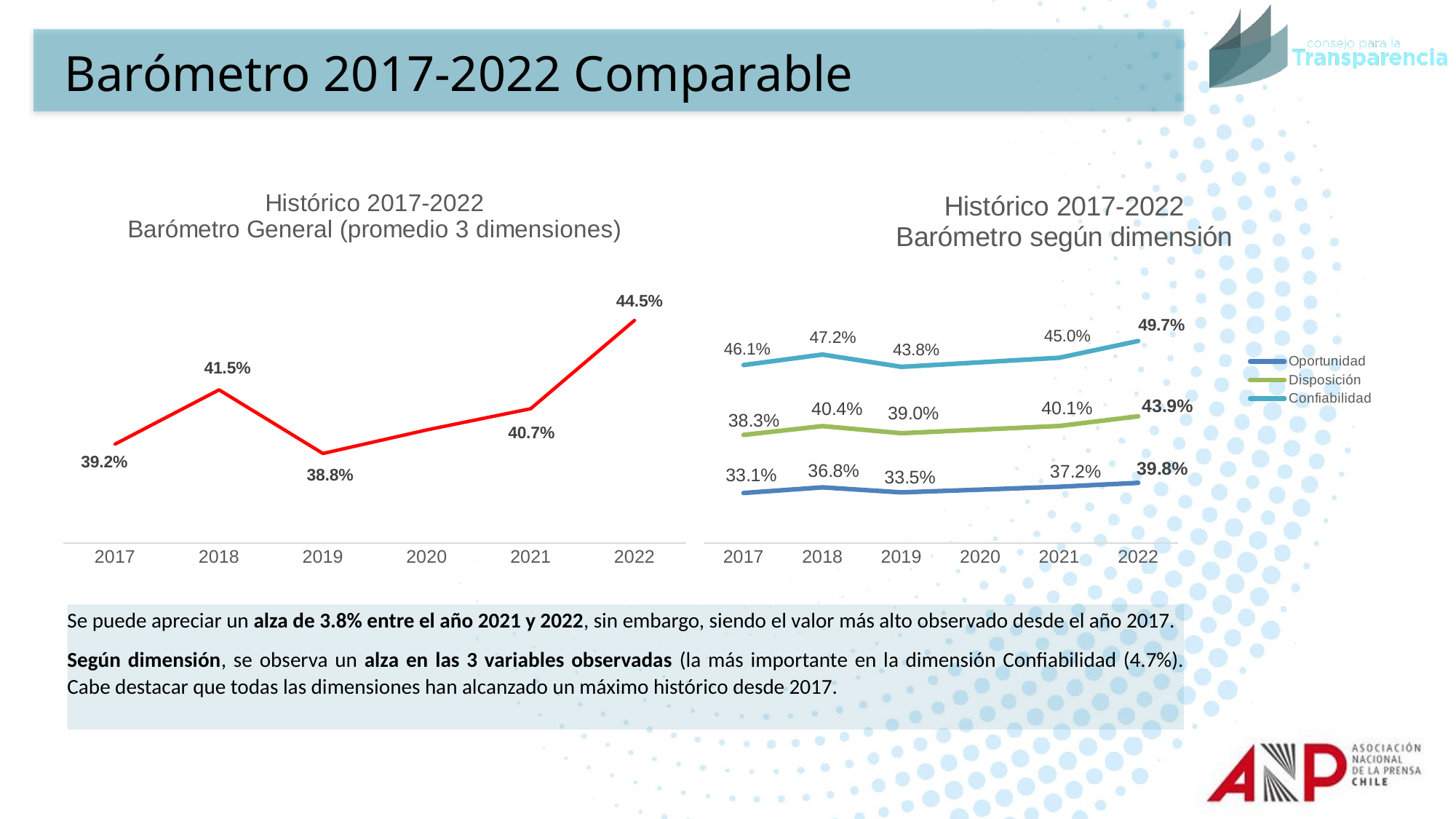
In the right chart (Barómetro según dimensión), which series has the highest value in 2022? Confiabilidad In the right chart (Barómetro según dimensión), what is the value for Confiabilidad in 2022? 49.7% In the left chart (Barómetro General), what is the value for 2022? 44.5% In the left chart (Barómetro General), what is the difference between the 2022 and 2021 values? 3.8% In the left chart (Barómetro General), which year has the lowest value? 2019 In the right chart (Barómetro según dimensión), how many series does the legend list? 3 In the right chart (Barómetro según dimensión), is the Disposición value for 2021 larger or smaller than the Disposición value for 2022? Smaller In the right chart (Barómetro según dimensión), what is the value for Oportunidad in 2018? 36.8% In the right chart (Barómetro según dimensión), how many years are shown on the x axis? 6 In the left chart (Barómetro General), what type of chart is shown? Line chart In the left chart (Barómetro General), what is the value for 2019? 38.8% In the right chart (Barómetro según dimensión), what is the difference between Confiabilidad and Oportunidad in 2017? 13.0%